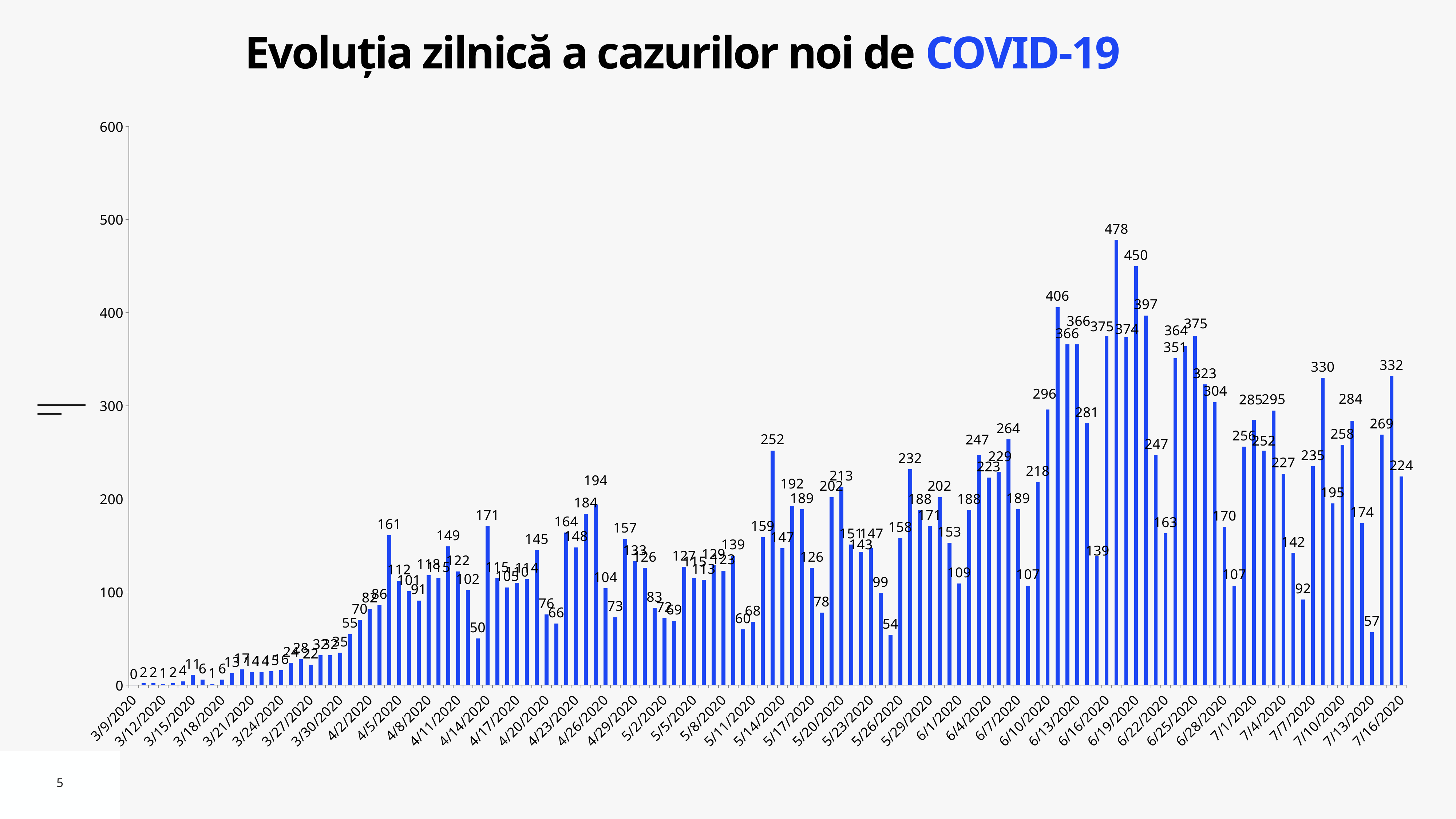
What is the value for the first date, 3/9/2020? 0 What is the lowest daily value shown in the chart? 0 What is the value for the last date, 7/16/2020? 224 What is the highest daily value shown in the chart? 478 Is the value for 7/16/2020 greater or less than 300? less Which is larger, the bar labelled 478 or the bar labelled 450? 478 What kind of chart is shown on the slide? bar chart Overall, do the values rise or fall from March to July along the x axis? rise Is the highest bar in the chart greater or less than 400? greater What is the title of the chart? Evoluția zilnică a cazurilor noi de COVID-19 What is the difference between the highest value (478) and the value for 7/16/2020 (224)? 254 What colour are the bars in the chart? blue